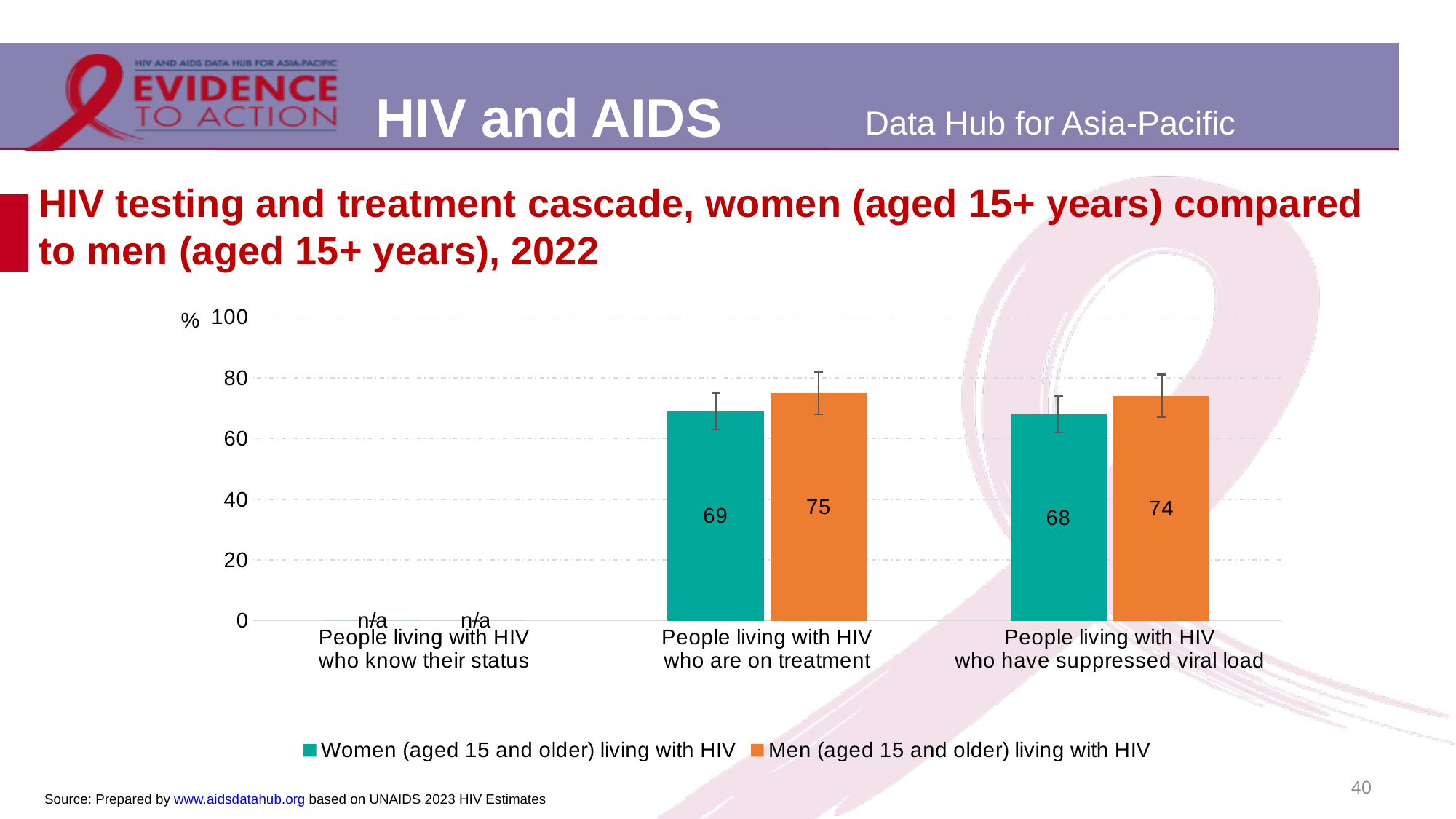
What is the difference between men and women for people living with HIV who have suppressed viral load? 6 Which series has the highest plotted value on the chart? Men (aged 15 and older) living with HIV What is shown for the 'People living with HIV who know their status' category? n/a What is the value for women (aged 15 and older) living with HIV who have suppressed viral load? 68 What kind of chart is shown on the slide? Bar chart How many categories are shown on the x axis? 3 Which is larger for people living with HIV who are on treatment: the value for women or the value for men? Men What is the value for women (aged 15 and older) living with HIV who are on treatment? 69 What is the difference between men and women for people living with HIV who are on treatment? 6 What is the value for men (aged 15 and older) living with HIV who are on treatment? 75 What is the value for men (aged 15 and older) living with HIV who have suppressed viral load? 74 How many series does the legend list? 2